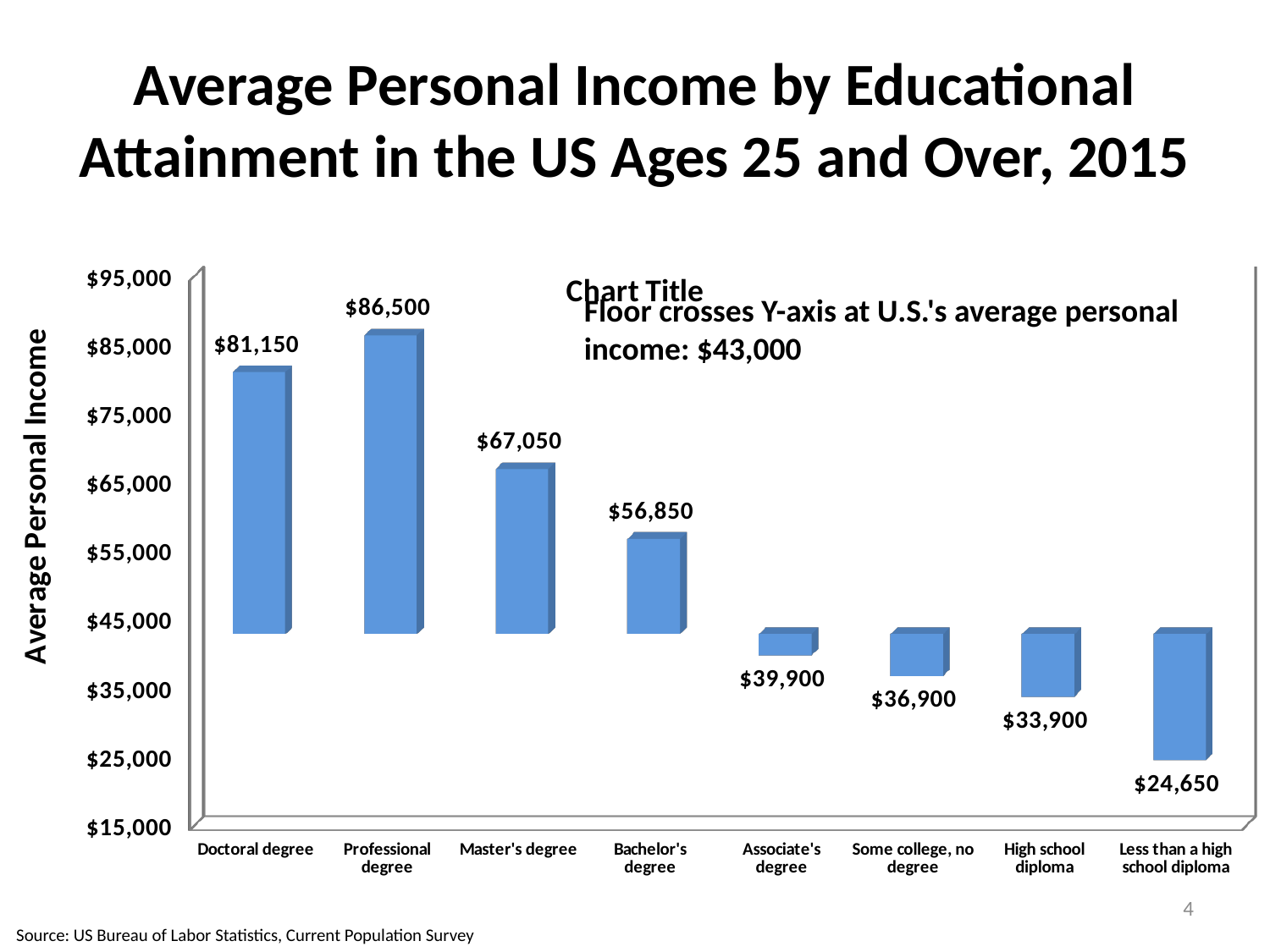
What is the average personal income for Less than a high school diploma? $24,650 According to the note on the chart, at what value does the floor cross the Y-axis? $43,000 Which educational attainment category has the lowest average personal income? Less than a high school diploma How many educational attainment categories are shown in the chart? 8 What kind of chart is shown on the slide? Bar chart What is the difference in average personal income between a Professional degree and a Doctoral degree? $5,350 What is the difference in average personal income between a Master's degree and a Bachelor's degree? $10,200 Which educational attainment category has the highest average personal income? Professional degree Do the values generally rise or fall moving from left to right along the x axis? Fall What is the average personal income for a Professional degree? $86,500 Which has a higher average personal income: Associate's degree or Some college, no degree? Associate's degree What is the average personal income for a Bachelor's degree? $56,850